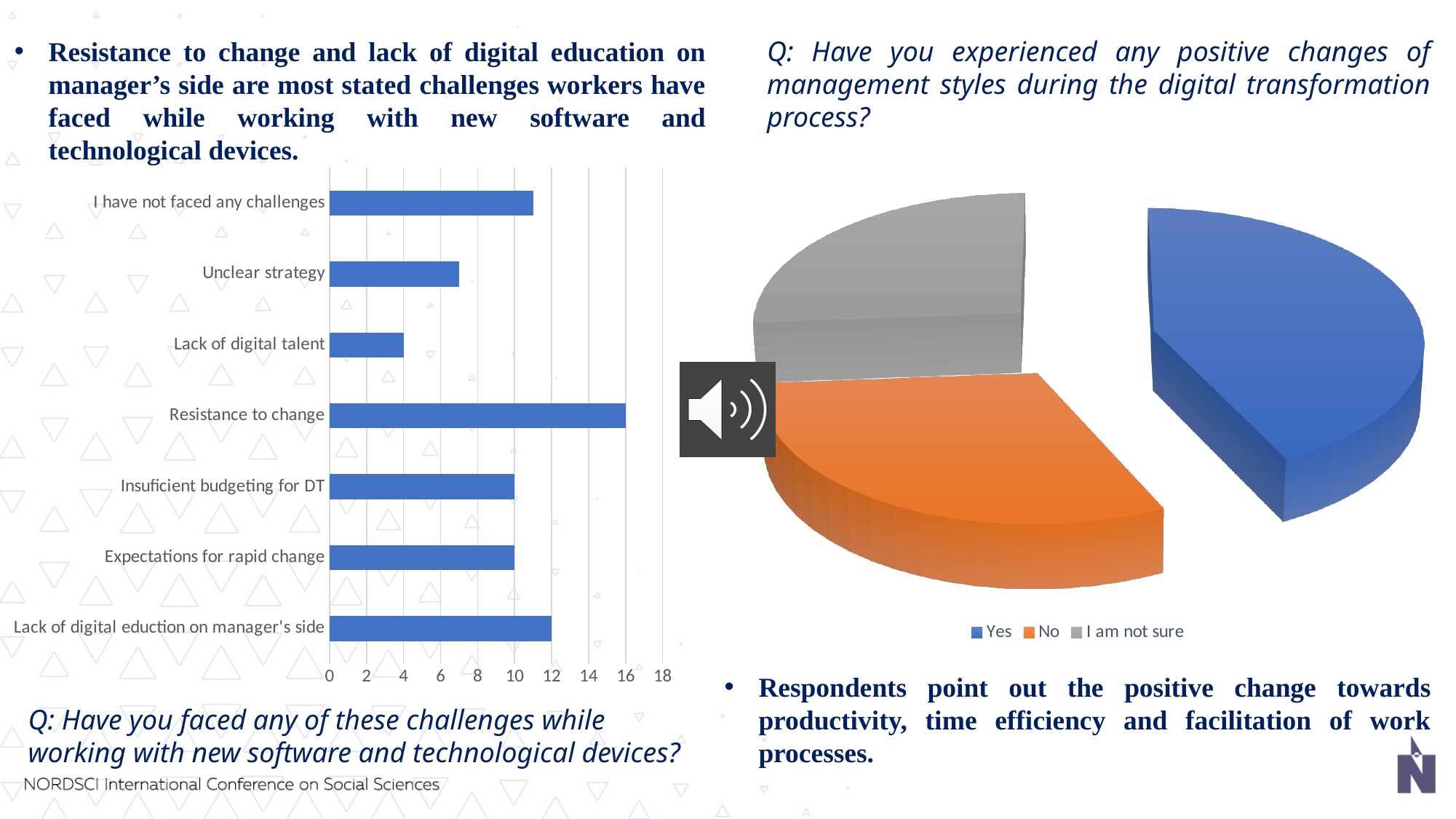
On the bar chart on the left, is the value for I have not faced any challenges greater or less than 10? greater On the bar chart on the left, what is the value for Resistance to change? 16 On the bar chart on the left, what is the value for Lack of digital eduction on manager's side? 12 How many entries does the legend of the pie chart on the right list? 3 On the bar chart on the left, which is larger: Resistance to change or Insuficient budgeting for DT? Resistance to change What kind of chart is the chart on the left of the slide? bar chart On the bar chart on the left, which category has the lowest value? Lack of digital talent How many categories does the bar chart on the left show? 7 On the bar chart on the left, which category has the highest value? Resistance to change On the bar chart on the left, what is the value for Lack of digital talent? 4 On the pie chart on the right, which answer has the largest slice? Yes On the bar chart on the left, is the value for Unclear strategy greater or less than 8? less